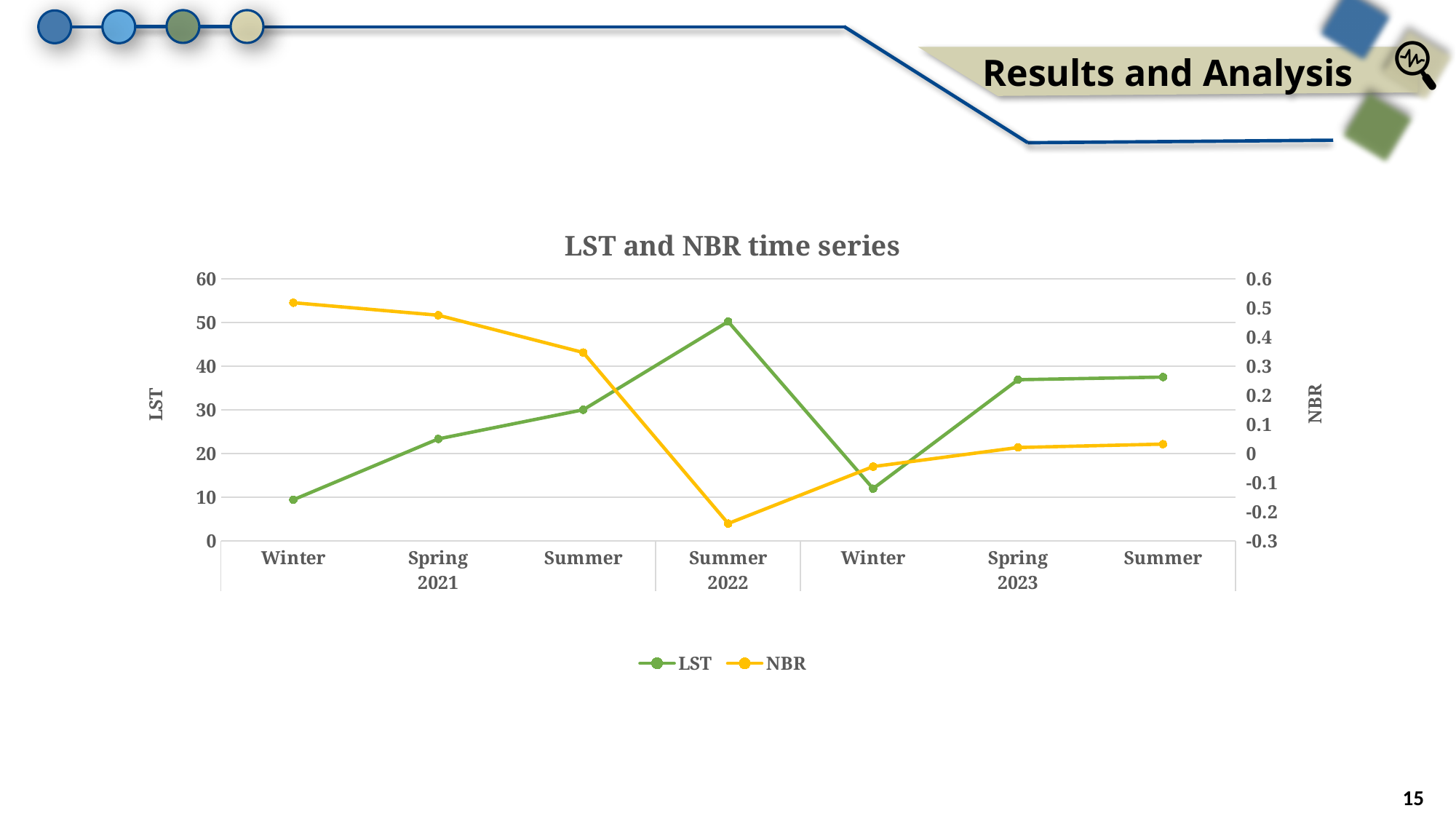
Is the LST value for Summer 2022 greater or less than 40? greater What type of chart is shown on the slide? line chart What is the title of the chart? LST and NBR time series At which point does the NBR series reach its highest value? Winter 2021 At which point does the LST series reach its highest value? Summer 2022 Which is larger, the LST value for Spring 2021 or the LST value for Spring 2023? Spring 2023 How many data points does each series have along the x axis? 7 Is the NBR value for Summer 2022 greater or less than 0? less Is the LST value for Winter 2021 greater or less than 20? less How many series does the legend list? 2 Does the NBR series rise or fall from Winter 2021 to Summer 2022? fall At which point does the NBR series reach its lowest value? Summer 2022